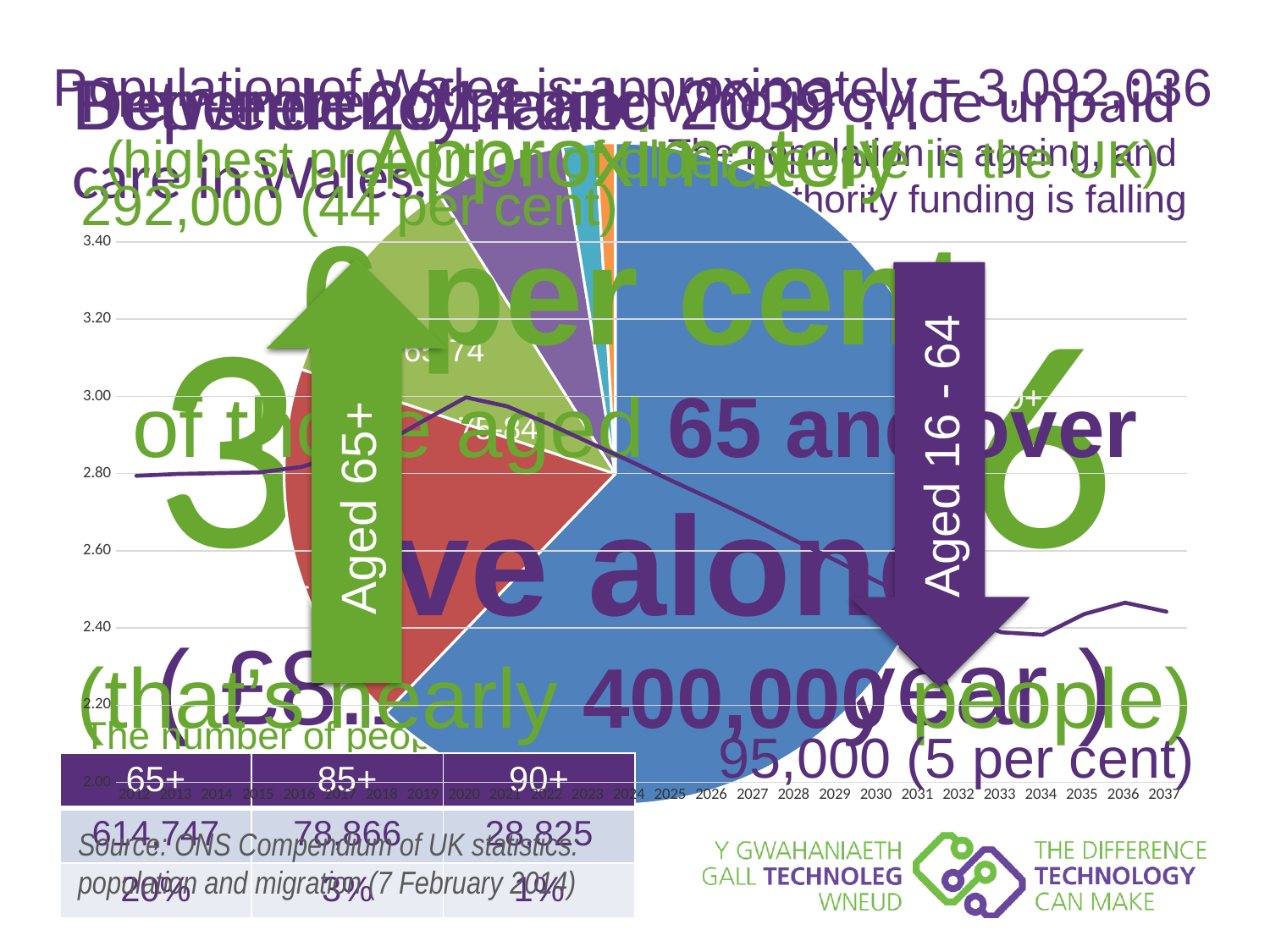
On the line chart, do the values rise or fall between 2012 and 2020? rise On the line chart, how many years are labelled along the x axis? 26 On the line chart, is the value for 2033 greater or less than 2.20? greater On the line chart, do the values rise or fall between 2020 and 2033? fall On the line chart, which is larger, the value for 2012 or the value for 2033? 2012 On the line chart, what is the highest value labelled on the y axis? 3.40 On the line chart, is the value for 2033 greater or less than 2.60? less What kind of chart is the chart with the years 2012 to 2037 along the x axis? line chart What kind of chart is the large chart in the centre of the slide with the coloured wedges? pie chart On the line chart, is the value for 2020 greater or less than 2.80? greater On the line chart, what is the first year shown on the x axis? 2012